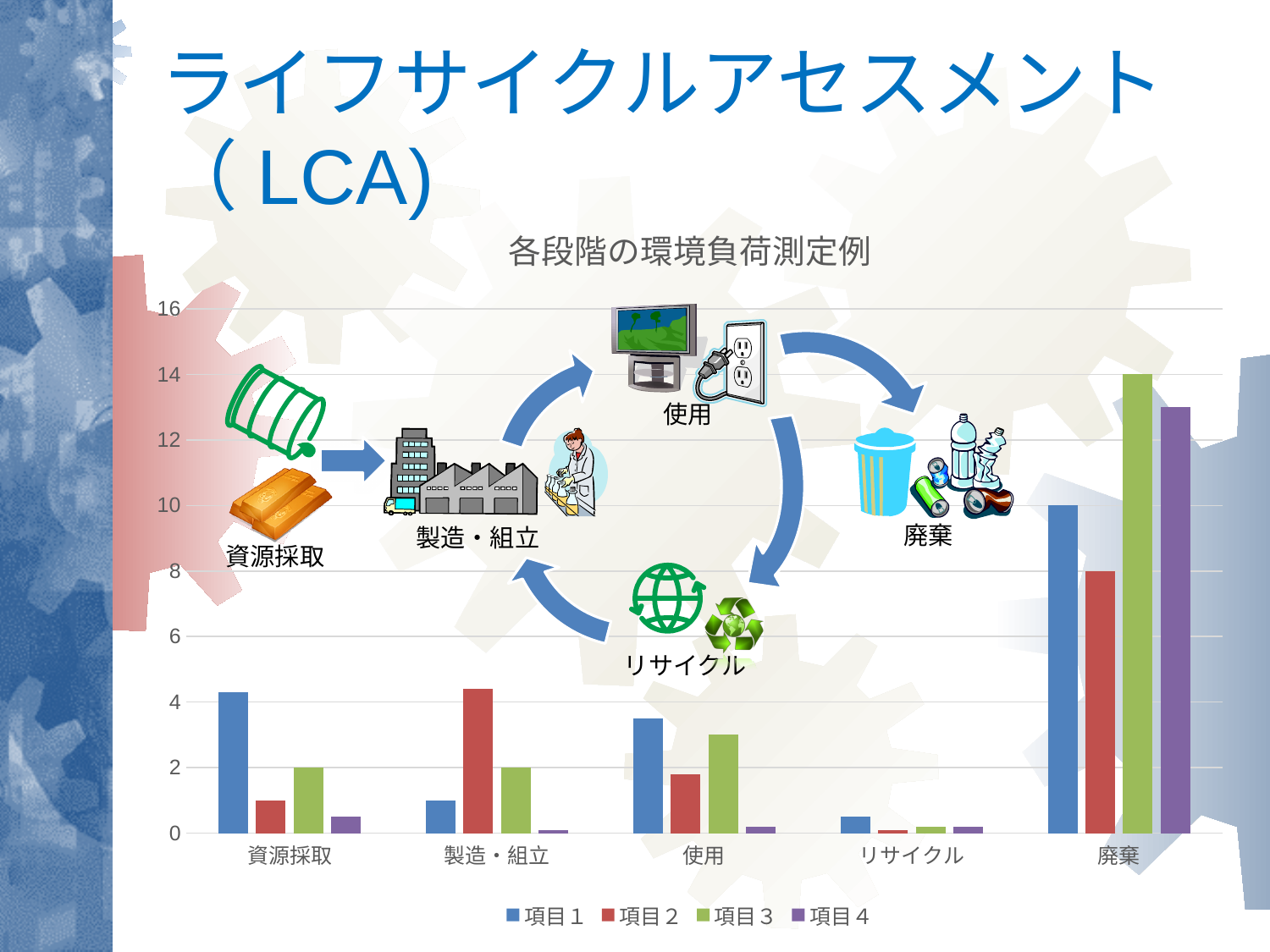
What is the value of 項目２ for 廃棄? 8 What is the difference between 項目３ and 項目１ for 廃棄? 4 What is the value of 項目１ for 廃棄? 10 How many categories are shown on the x axis of the chart? 5 Which category has the lowest bars overall in the chart? リサイクル For 廃棄, which is larger, 項目１ or 項目２? 項目１ How many series does the chart legend list? 4 What is the value of 項目３ for 廃棄? 14 Which category has the highest bar in the chart? 廃棄 What is the value of 項目３ for 資源採取? 2 What kind of chart is shown on the slide? bar chart What is the title of the chart? 各段階の環境負荷測定例